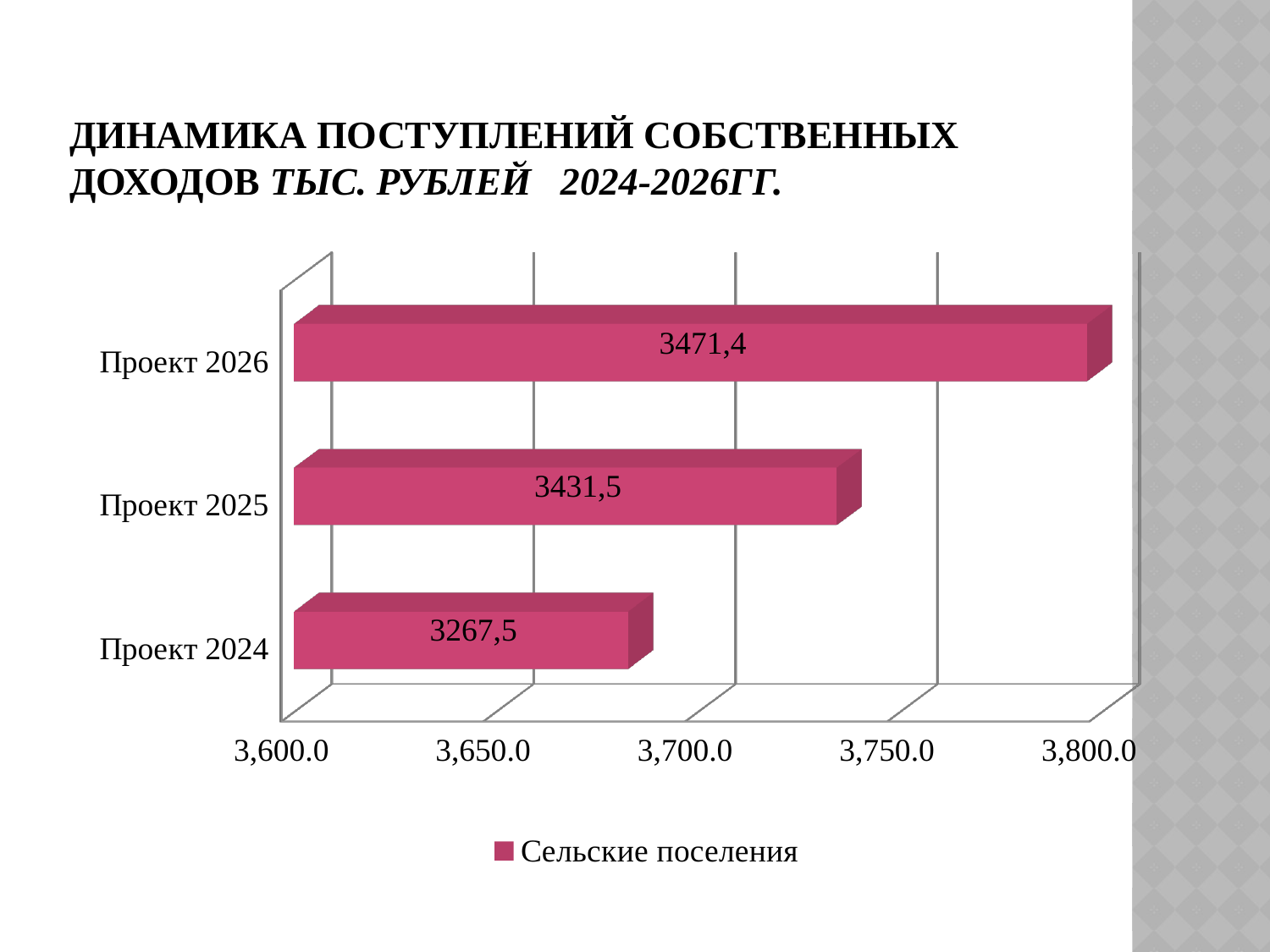
What kind of chart is shown on the slide? Bar chart Which category has the highest value? Проект 2026 How many categories are plotted in the chart? 3 What is the value shown for Проект 2026? 3471,4 What is the value shown for Проект 2024? 3267,5 What is the value shown for Проект 2025? 3431,5 How many series does the legend list? 1 What is the difference between the values for Проект 2026 and Проект 2025? 39,9 Which is larger, the value for Проект 2025 or the value for Проект 2024? Проект 2025 Which category has the lowest value? Проект 2024 What is the name of the series shown in the legend? Сельские поселения What is the difference between the values for Проект 2025 and Проект 2024? 164,0